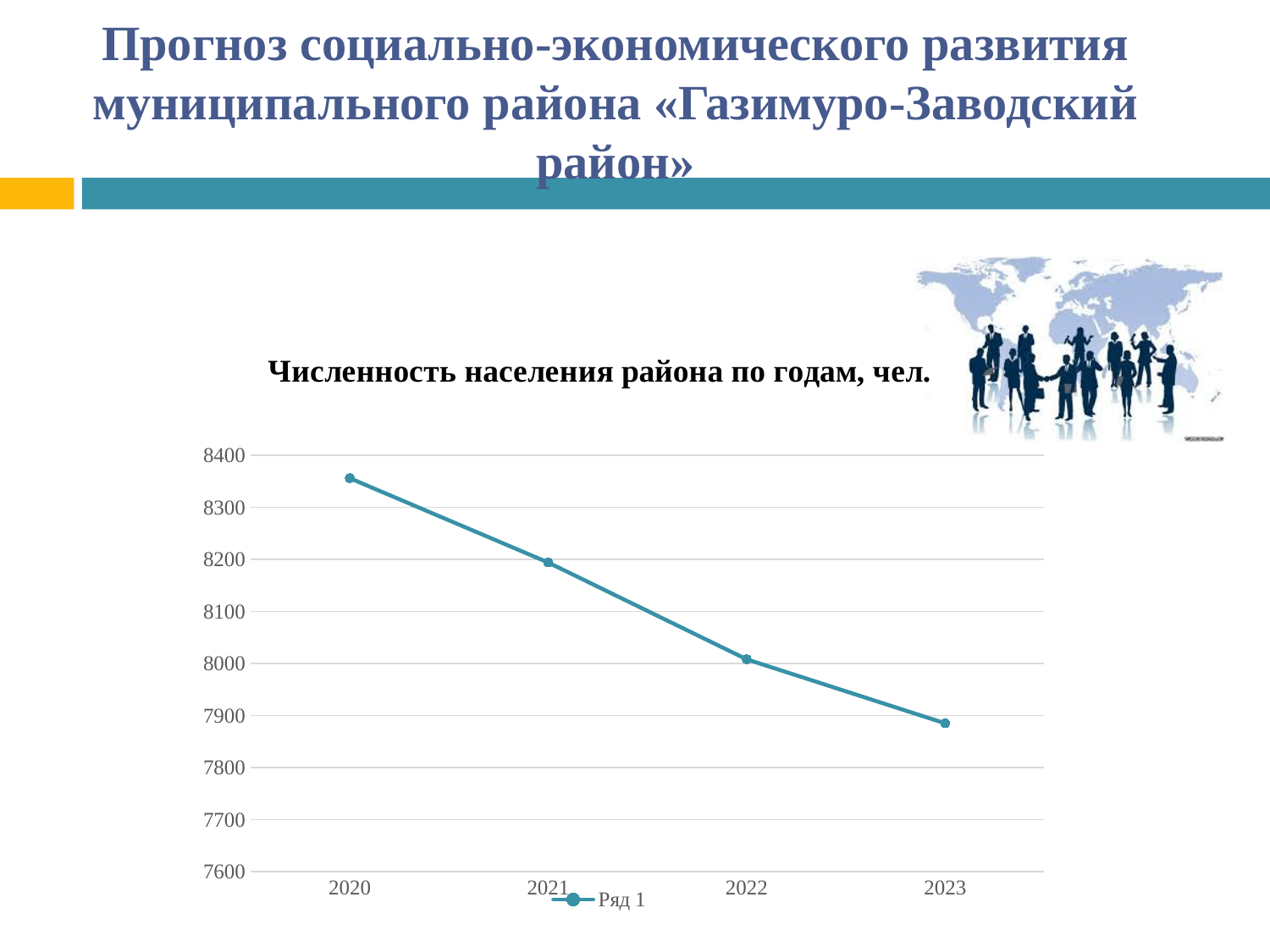
Which is larger, the value for 2021 or the value for 2022? 2021 Which year has the lowest population value? 2023 What is the title of the chart? Численность населения района по годам, чел. How many years are plotted on the x axis of the chart? 4 Is the value for 2022 greater or less than 8100? less Is the value for 2023 greater or less than 8000? less What kind of chart is shown on the slide? line chart Do the values rise or fall from 2020 to 2023? fall Is the value for 2020 greater or less than 8300? greater What is the name of the series shown in the legend? Ряд 1 Which year has the highest population value? 2020 How many series does the legend list? 1